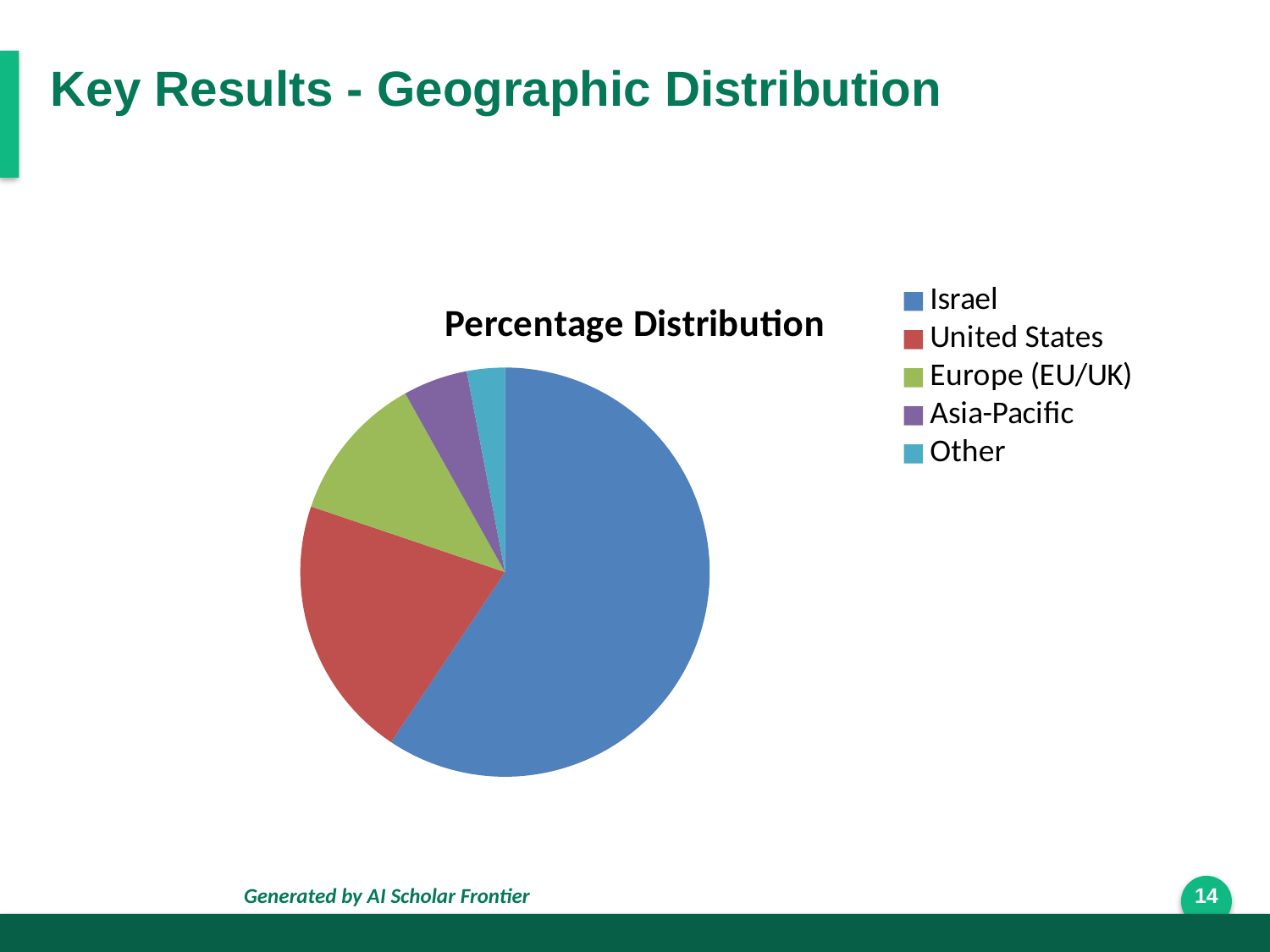
Which category has the largest slice of the pie chart? Israel Which category has the second-largest slice of the pie chart? United States Which slice is larger, United States or Europe (EU/UK)? United States Which category has the smallest slice of the pie chart? Other Which slice is larger, Israel or United States? Israel How many categories does the legend of the pie chart list? 5 What is the title of the chart? Percentage Distribution Which slice is larger, Europe (EU/UK) or Asia-Pacific? Europe (EU/UK) What kind of chart is shown on the slide? Pie chart Which category is shown in blue in the pie chart? Israel